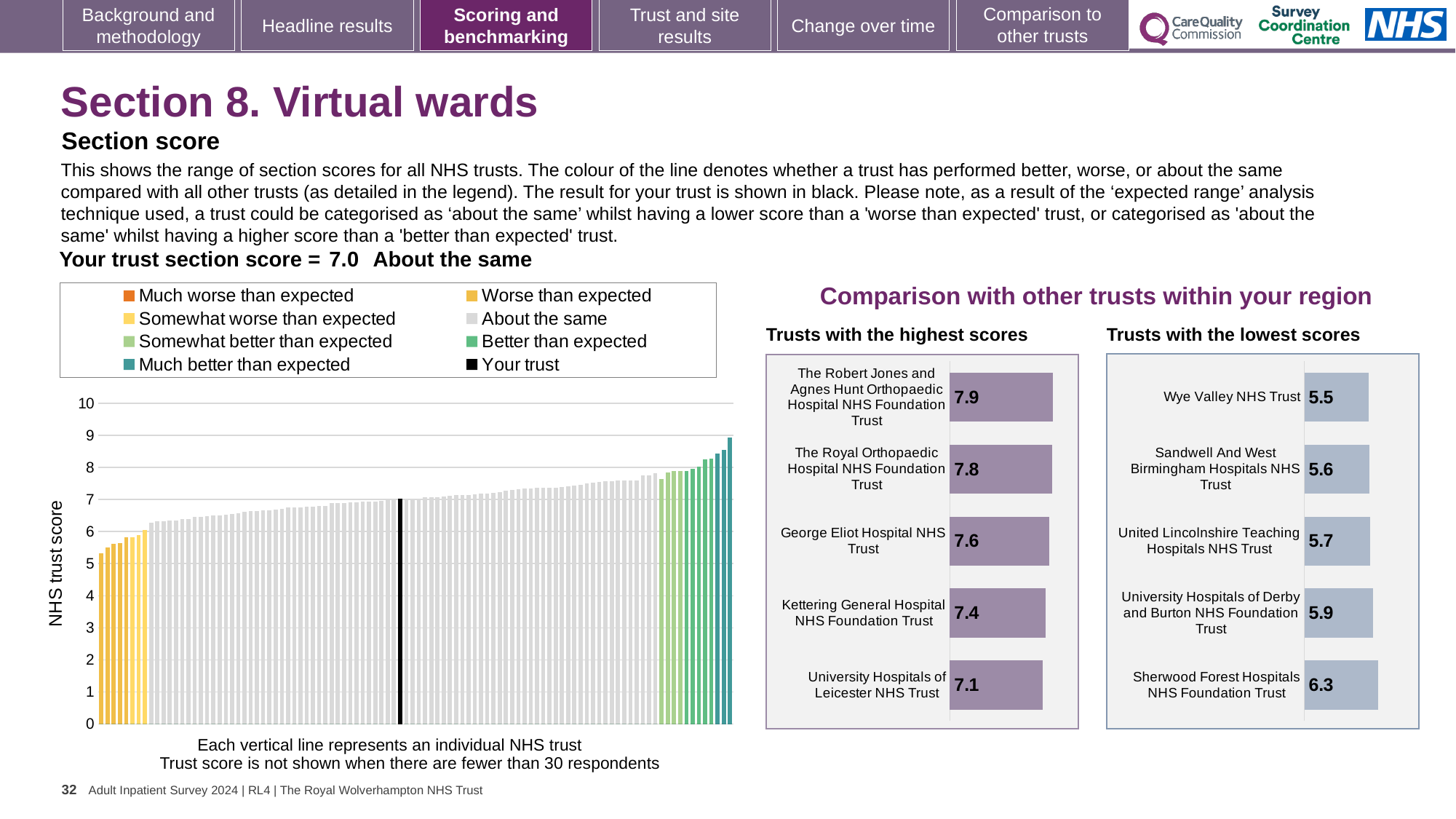
In the 'Trusts with the lowest scores' chart, which has the larger score: Sandwell And West Birmingham Hospitals NHS Trust or University Hospitals of Derby and Burton NHS Foundation Trust? University Hospitals of Derby and Burton NHS Foundation Trust In the 'Trusts with the lowest scores' chart, which trust has the lowest score? Wye Valley NHS Trust In the large chart on the left showing NHS trust scores, do the values rise or fall from left to right? rise What is the y-axis label of the large chart on the left? NHS trust score In the 'Trusts with the highest scores' chart, what is the difference between the scores of The Robert Jones and Agnes Hunt Orthopaedic Hospital NHS Foundation Trust and University Hospitals of Leicester NHS Trust? 0.8 According to the slide, what is your trust's section score for Virtual wards? 7.0 In the 'Trusts with the lowest scores' chart, what is the score for Sherwood Forest Hospitals NHS Foundation Trust? 6.3 What kind of chart is the large chart on the left showing NHS trust scores? bar chart How many trusts are listed in the 'Trusts with the highest scores' chart? 5 In the 'Trusts with the highest scores' chart, which trust has the highest score? The Robert Jones and Agnes Hunt Orthopaedic Hospital NHS Foundation Trust How many entries does the legend of the large chart on the left list? 8 In the 'Trusts with the highest scores' chart, what is the score for The Robert Jones and Agnes Hunt Orthopaedic Hospital NHS Foundation Trust? 7.9